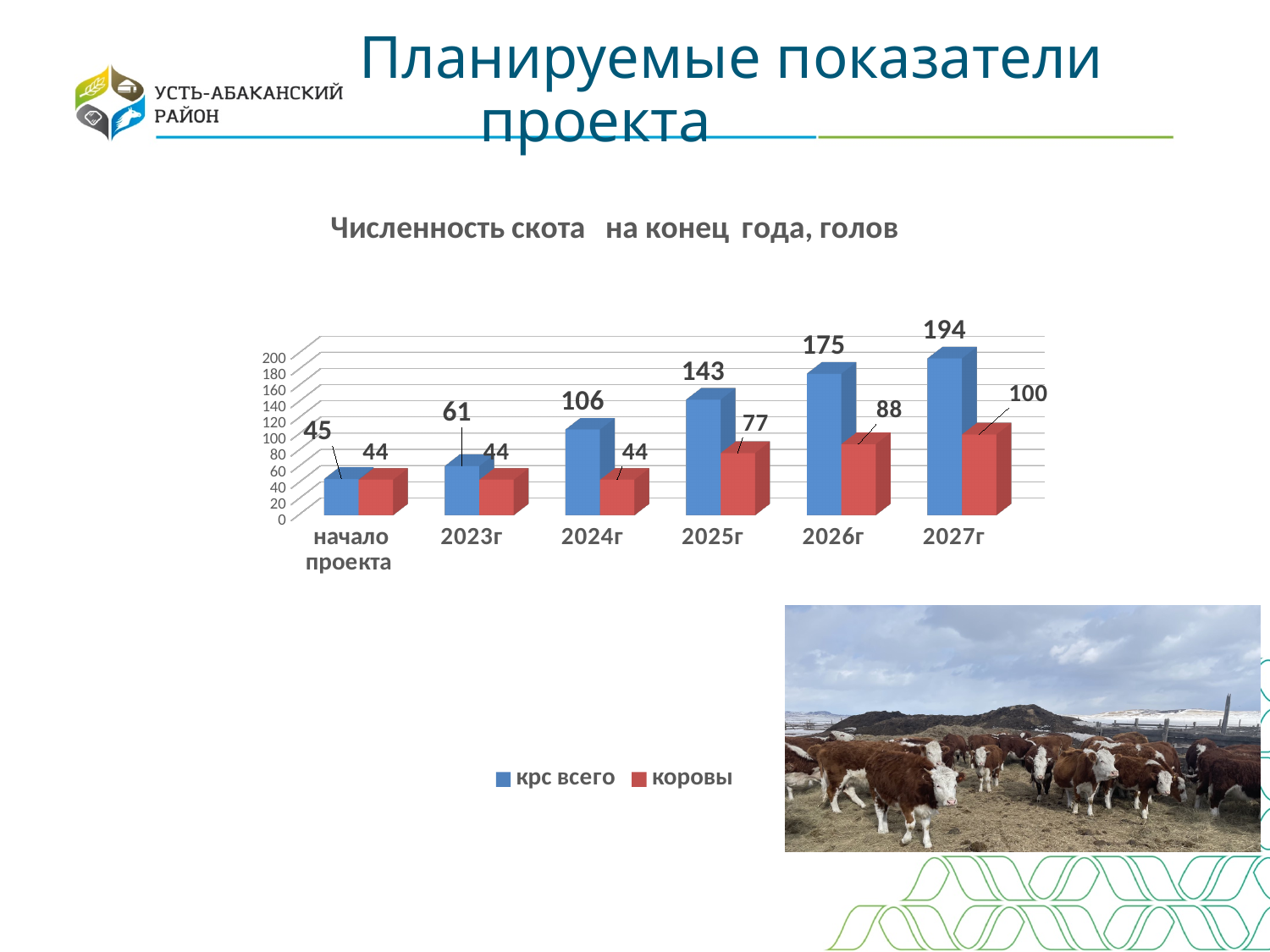
What is the value for 'крс всего' in 2027г? 194 What is the difference between 'крс всего' and 'коровы' in 2026г? 87 Which category has the lowest value for 'крс всего'? начало проекта Do the values for 'крс всего' rise or fall from 'начало проекта' to 2027г? rise What is the title of the chart? Численность скота на конец года, голов How many categories are shown on the x axis? 6 Which category has the highest value for 'крс всего'? 2027г Which is larger: 'коровы' in 2024г or 'коровы' in 2027г? 2027г What is the value for 'коровы' in 2025г? 77 How many series does the legend list? 2 What is the value for 'крс всего' at 'начало проекта'? 45 What kind of chart is shown? bar chart